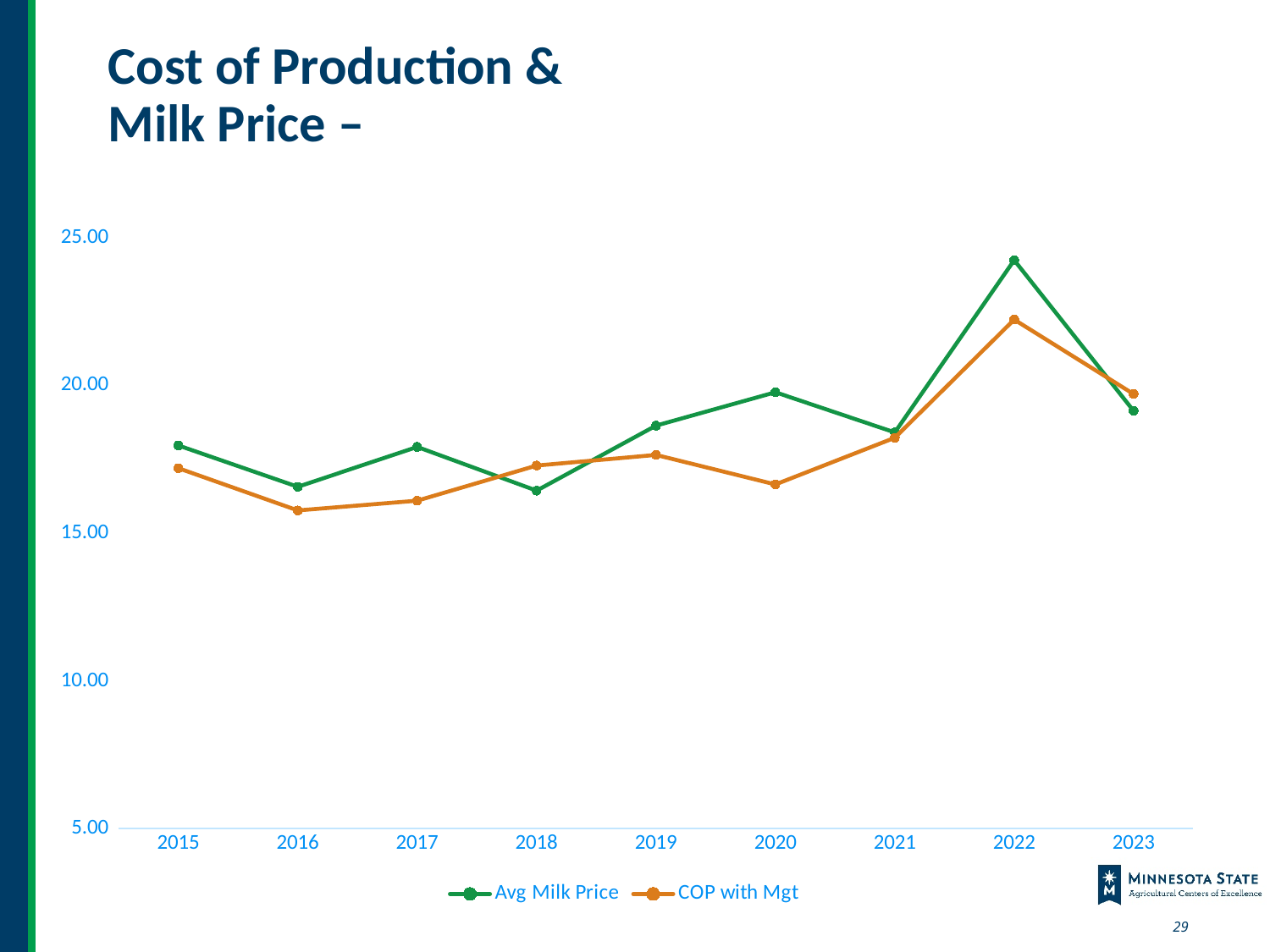
In 2022, which is larger: Avg Milk Price or COP with Mgt? Avg Milk Price What kind of chart is shown on the slide? Line chart Is the Avg Milk Price in 2022 greater or less than 20.00? greater How many series does the legend list? 2 In which year is COP with Mgt highest? 2022 How many years are plotted along the x axis? 9 In 2018, which is larger: Avg Milk Price or COP with Mgt? COP with Mgt Is the Avg Milk Price in 2020 greater or less than 20.00? less What colour is the Avg Milk Price line? Green Does the Avg Milk Price rise or fall from 2022 to 2023? Fall In which year is the Avg Milk Price highest? 2022 Is the COP with Mgt value in 2016 greater or less than 15.00? greater